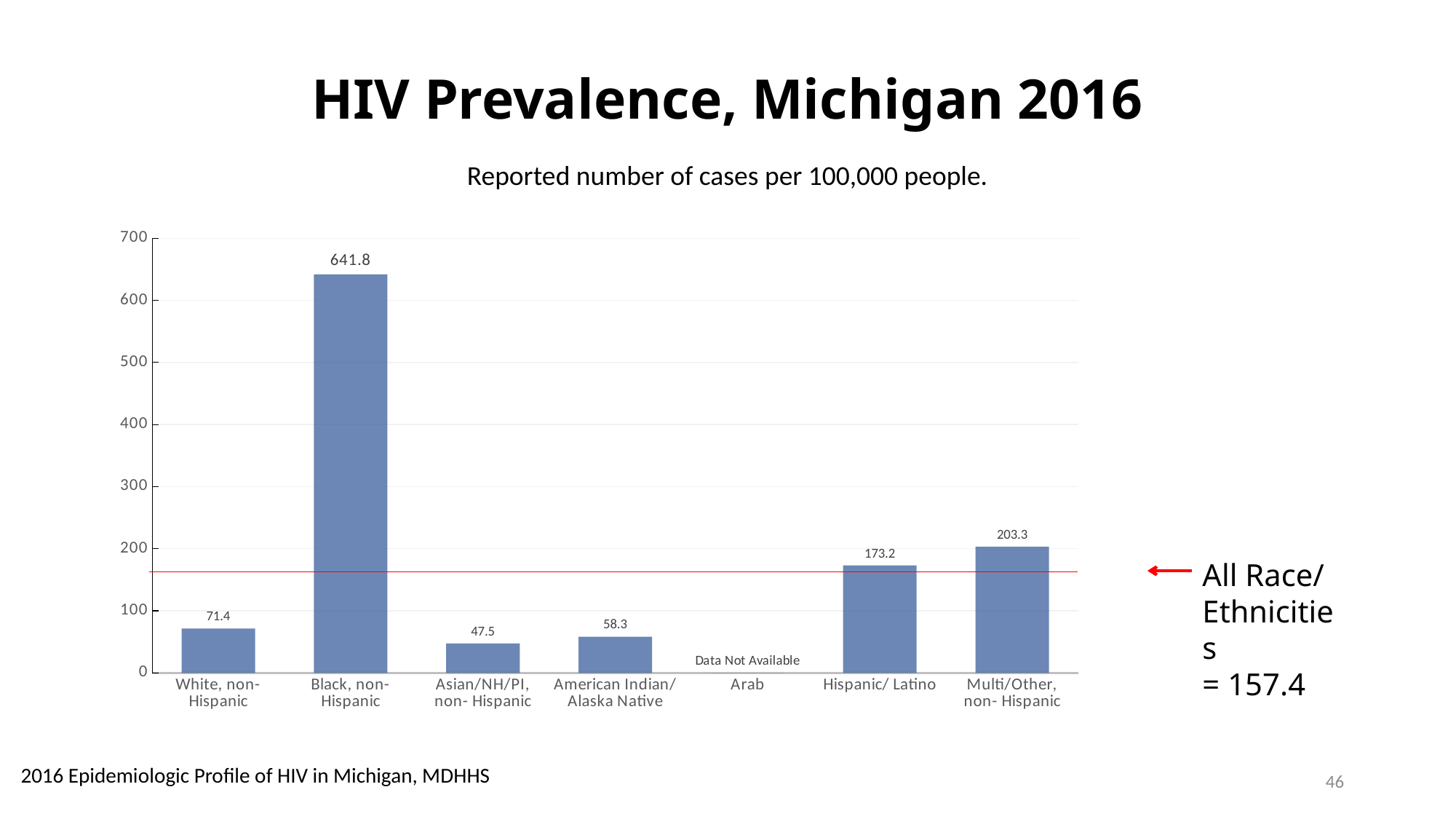
What is the value shown for Multi/Other, non- Hispanic? 203.3 How many categories are listed on the x axis? 7 Is the value for Black, non-Hispanic greater or less than 600? greater Which category has the highest HIV prevalence? Black, non-Hispanic What is the HIV prevalence value for Black, non-Hispanic? 641.8 Which is larger, the value for American Indian/ Alaska Native or the value for Asian/NH/PI, non- Hispanic? American Indian/ Alaska Native What is the difference between the values for Multi/Other, non- Hispanic and Hispanic/ Latino? 30.1 Which category with a plotted bar has the lowest HIV prevalence? Asian/NH/PI, non- Hispanic What is the value shown for Hispanic/ Latino? 173.2 What kind of chart is shown on the slide? bar chart What is the HIV prevalence value for White, non-Hispanic? 71.4 What is the value given for All Race/Ethnicities, marked by the horizontal line? 157.4